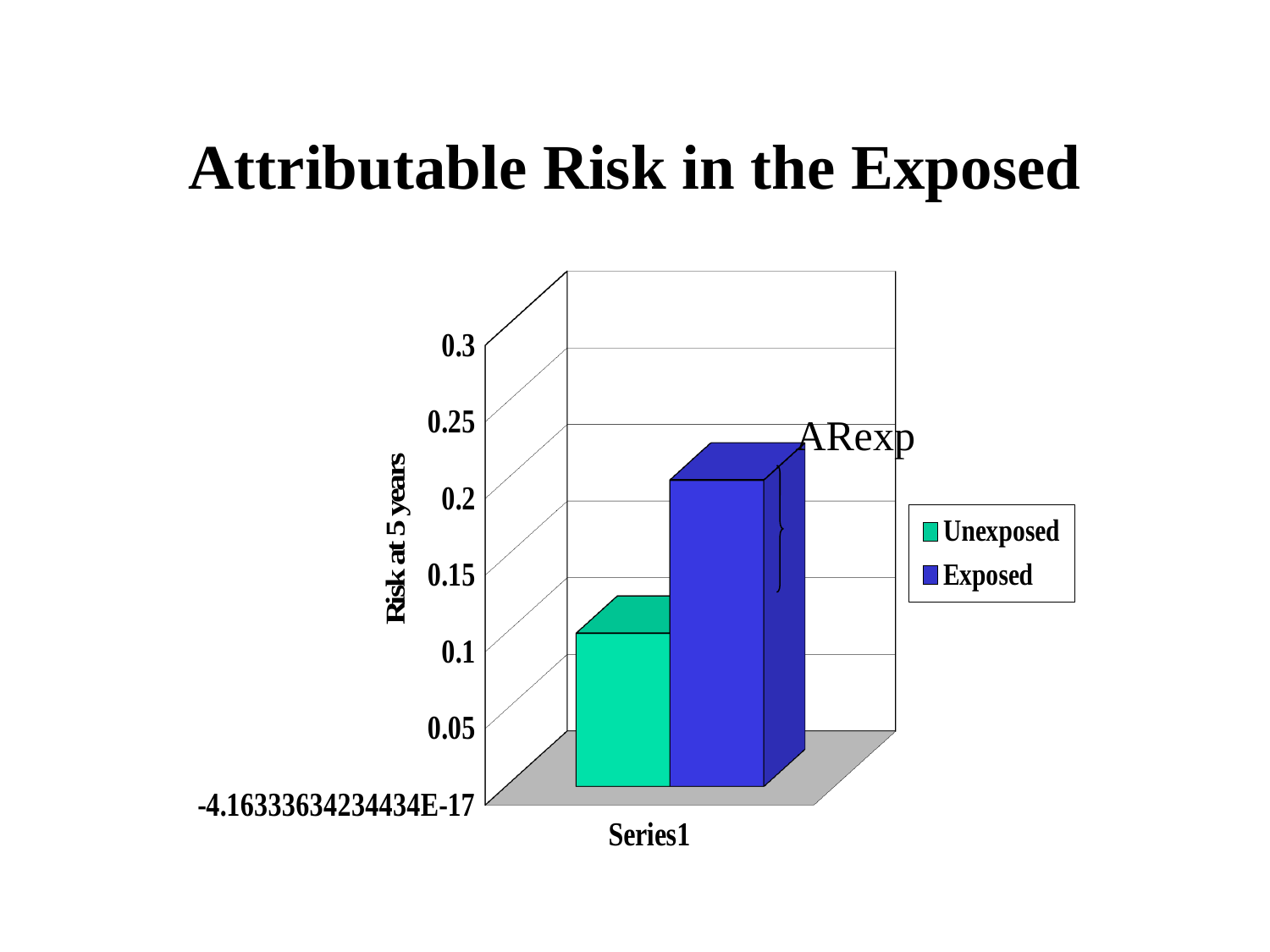
Which series has the taller bar, Unexposed or Exposed? Exposed Which series has the lowest risk at 5 years? Unexposed What is the label of the vertical axis? Risk at 5 years Is the value for Exposed greater or less than 0.25? less Which series has the highest risk at 5 years? Exposed Is the value for Unexposed greater or less than 0.05? greater How many categories are shown on the x axis? 1 What is the title of the chart? Attributable Risk in the Exposed Is the value for Exposed greater or less than 0.15? greater How many series does the legend list? 2 What kind of chart is shown on the slide? bar chart